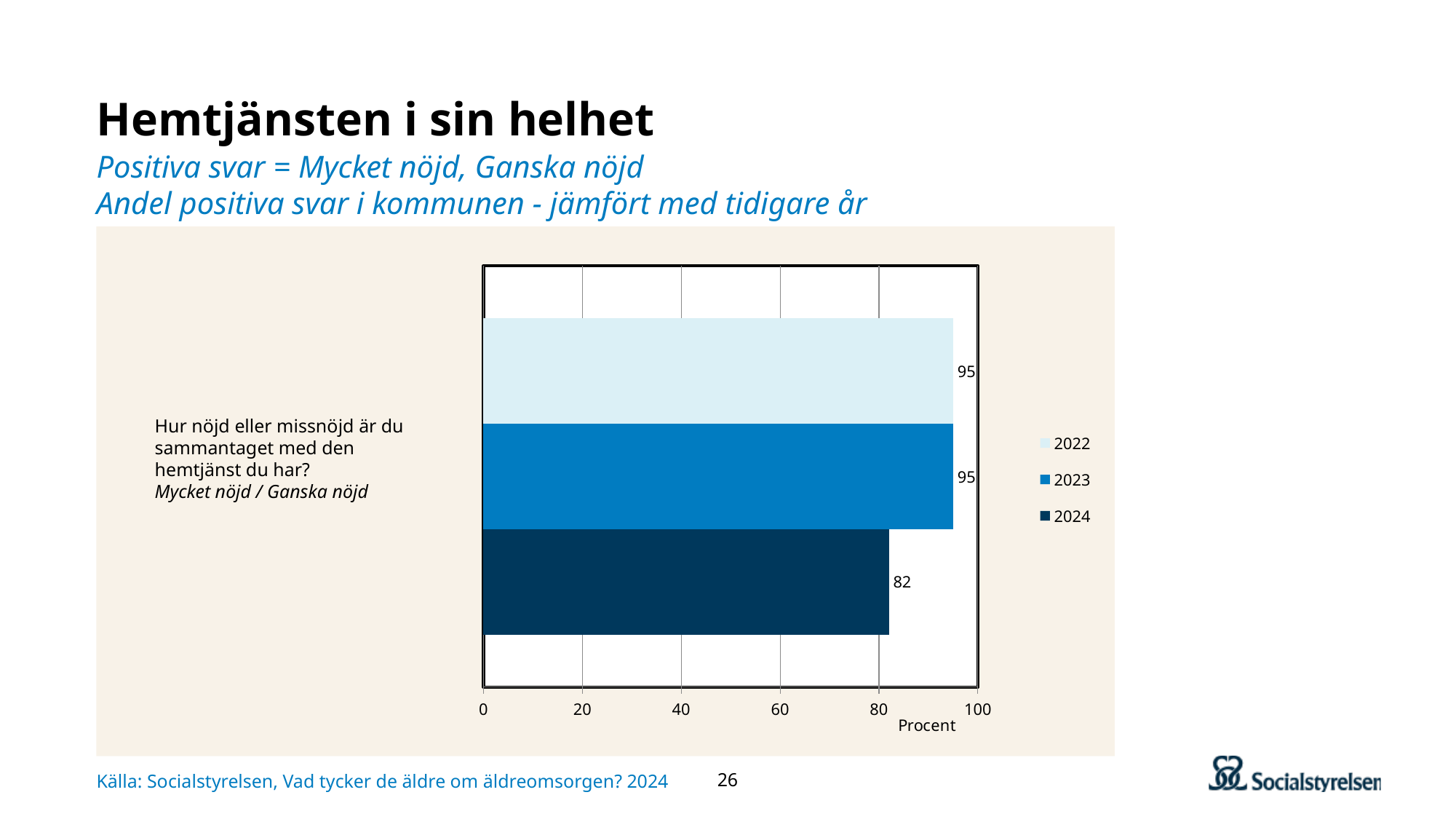
What is the label of the horizontal axis? Procent How many series does the legend list? 3 Which year has the lowest value in the chart? 2024 What kind of chart is shown on the slide? bar chart What is the value for 2023 in the chart? 95 Do the values rise or fall from 2022 to 2024? fall Is the value for 2023 greater or less than 100? less What is the value for 2024 in the chart? 82 Which is larger, the value for 2022 or the value for 2024? 2022 Is the value for 2024 greater or less than 80? greater What is the difference between the 2023 value and the 2024 value? 13 What is the value for 2022 in the chart? 95